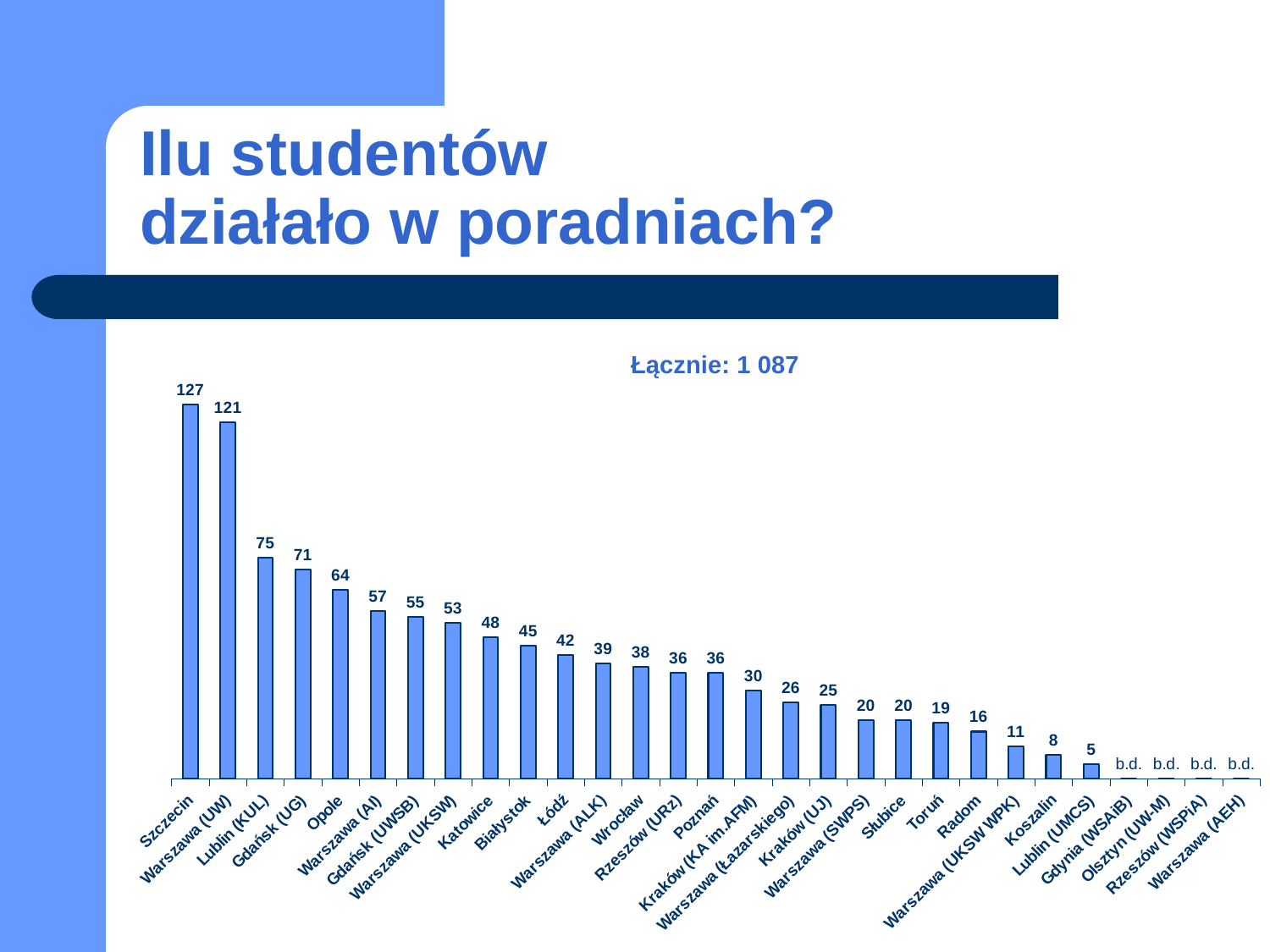
Which category has the lowest numeric value in the chart (excluding those marked b.d.)? Lublin (UMCS) How many students were active at Szczecin according to the chart? 127 What is the value shown for Warszawa (UW)? 121 What is the value shown for Kraków (UJ)? 25 Which has a larger value, Opole or Katowice? Opole What is the difference between the values for Lublin (KUL) and Gdańsk (UG)? 4 What is the value shown for Lublin (UMCS)? 5 What is the difference between the values for Szczecin and Warszawa (UW)? 6 What total is stated above the chart (Łącznie)? 1 087 Which category has the highest value in the chart? Szczecin What kind of chart is shown on the slide? bar chart How many categories are shown on the x axis of the chart? 29